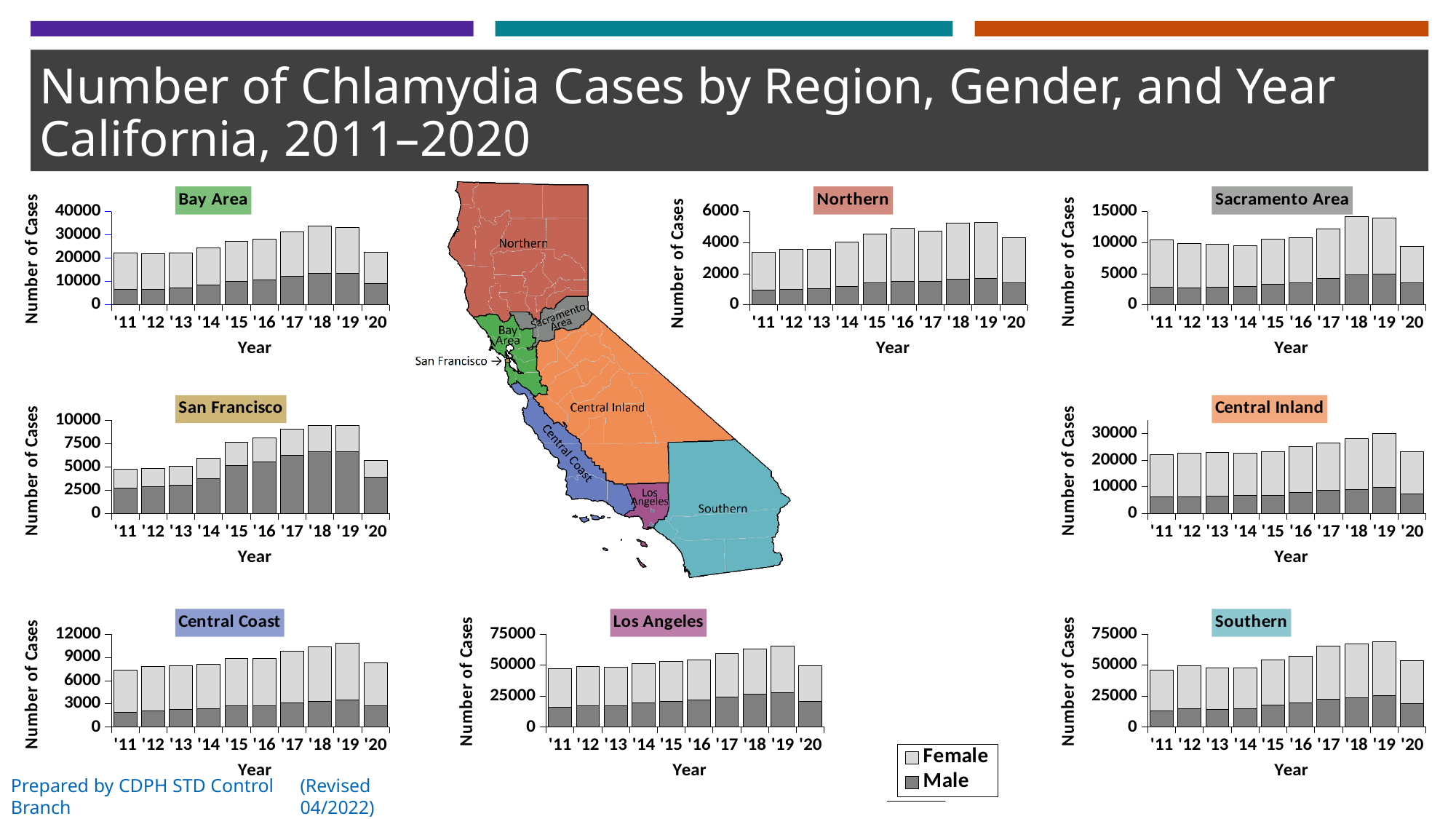
In the Bay Area chart, is the total value for '20 greater or less than 30000? less How many series does the legend list? 2 What kind of chart is the Bay Area chart? bar chart In the Central Inland chart, which year has the highest total number of cases? '19 Which series is shown in the darker grey colour in the legend? Male How many years are shown on the x axis of the Los Angeles chart? 10 In the San Francisco chart, is the total value for '20 greater or less than 7500? less In the Los Angeles chart, which year has the highest total number of cases? '19 In the Southern chart, which is larger, the total for '19 or the total for '11? '19 In the Bay Area chart, do the total values generally rise or fall from '11 to '19? rise In the Northern chart, is the total value for '11 greater or less than 4000? less